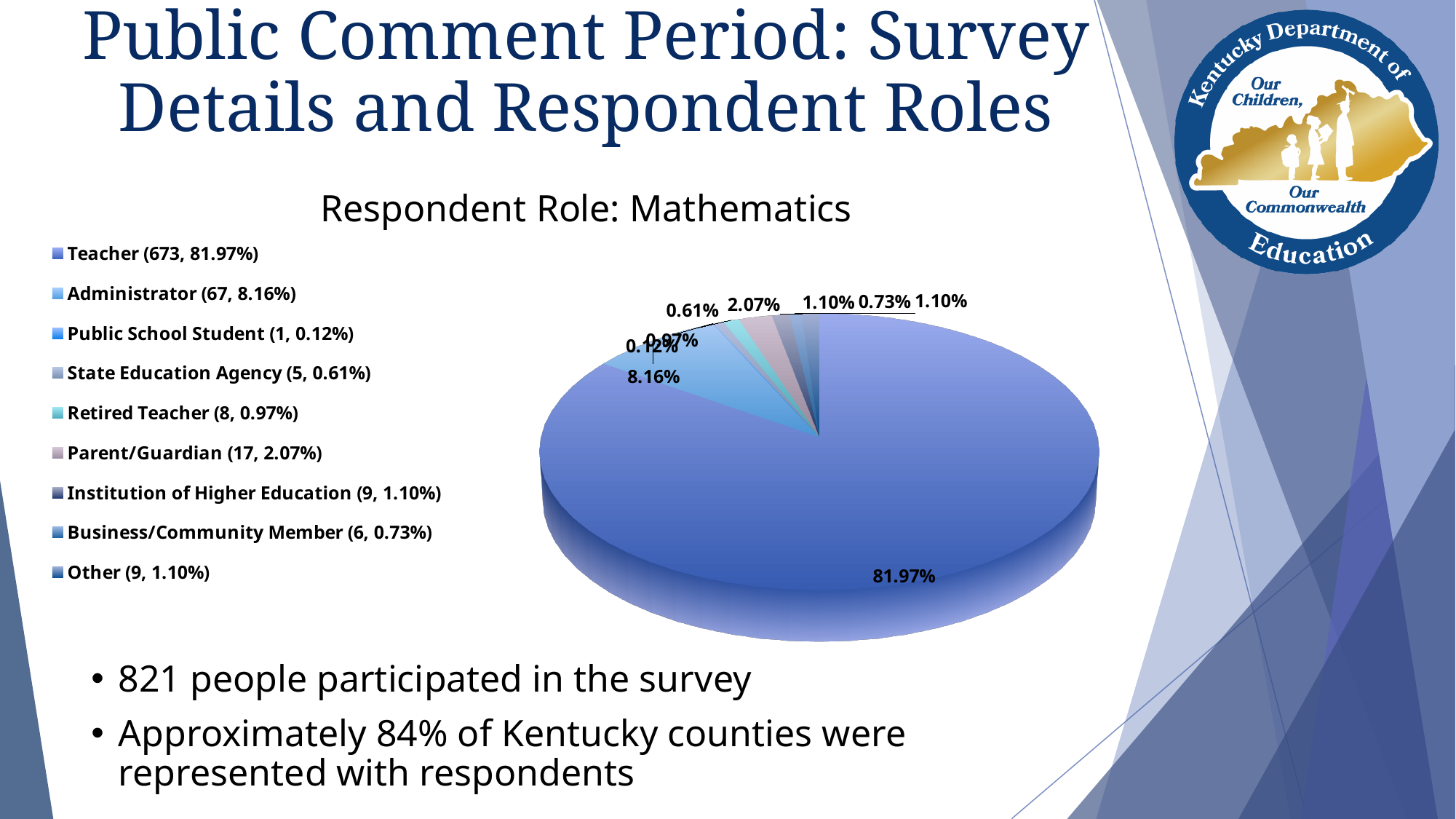
What percentage of respondents were Administrators? 8.16% Which respondent role has the largest share of the pie? Teacher What kind of chart is shown on the slide? Pie chart How many respondents were Parent/Guardian? 17 What is the title of the chart? Respondent Role: Mathematics What percentage of respondents were from a State Education Agency? 0.61% Which respondent role has the smallest share of the pie? Public School Student How many respondent role categories does the pie chart show? 9 What is the difference in the number of respondents between Teacher and Administrator? 606 How many respondents were Retired Teachers? 8 Which had more respondents, Parent/Guardian or Retired Teacher? Parent/Guardian What percentage of respondents were Teachers? 81.97%